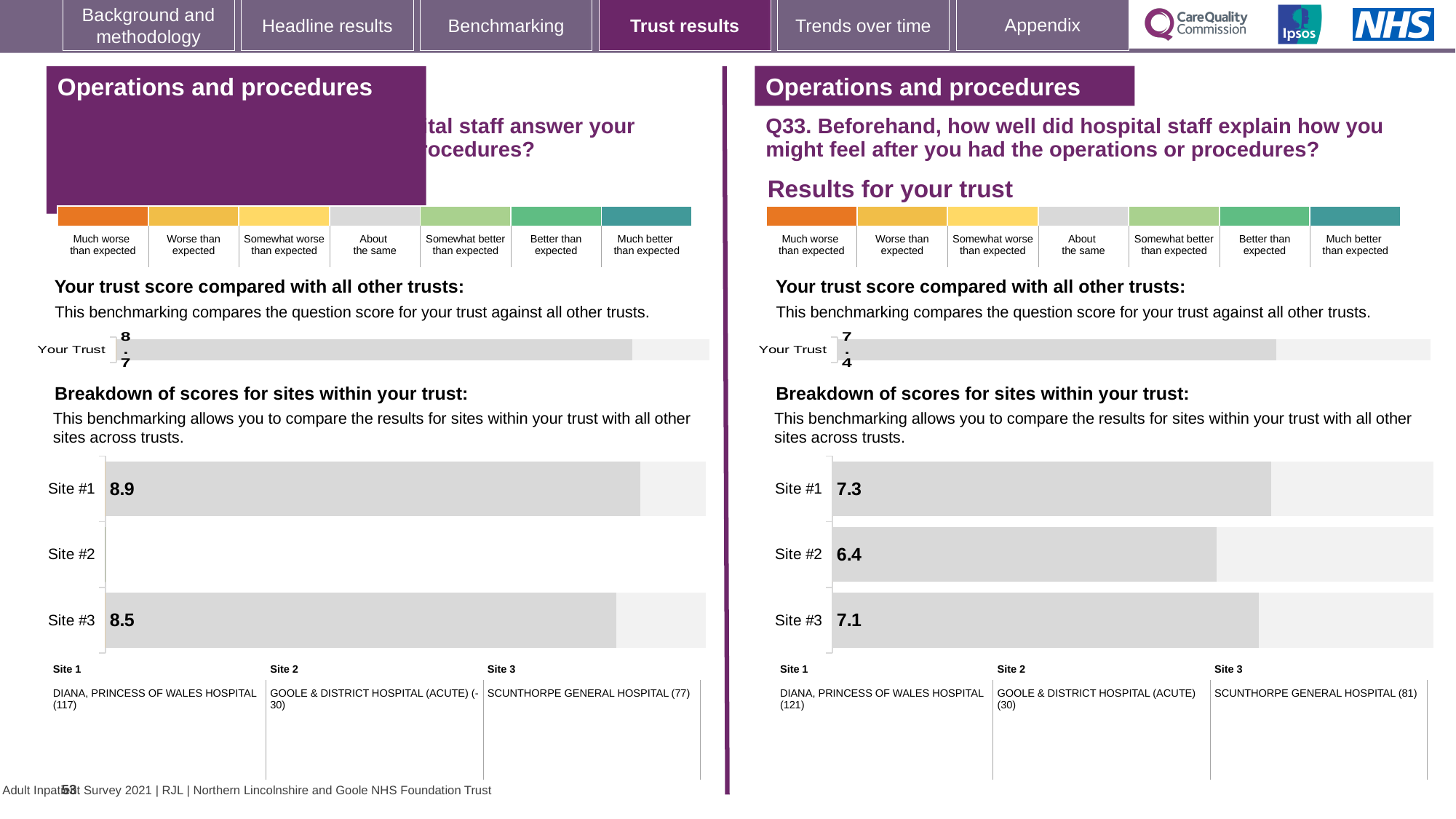
On the right-hand chart for Q33, which site has the lowest score? Site #2 On the left-hand site breakdown chart, what is the difference between the Site #1 and Site #3 scores? 0.4 On the right-hand chart for Q33, what is the score for Site #1? 7.3 On the left-hand site breakdown chart, which is larger, the score for Site #1 or Site #3? Site #1 On the right-hand chart for Q33, what is the score for Site #3? 7.1 What kind of chart is used for the site breakdown on the right-hand side of the slide? Bar chart On the right-hand chart for Q33, what is the difference between the Site #1 and Site #2 scores? 0.9 On the left-hand site breakdown chart, what is the score for Site #1? 8.9 On the right-hand chart for Q33, what is the score for Site #2? 6.4 How many sites are listed on the right-hand site breakdown chart for Q33? 3 On the left-hand site breakdown chart, what is the score for Site #3? 8.5 On the right-hand chart for Q33, which site has the highest score? Site #1